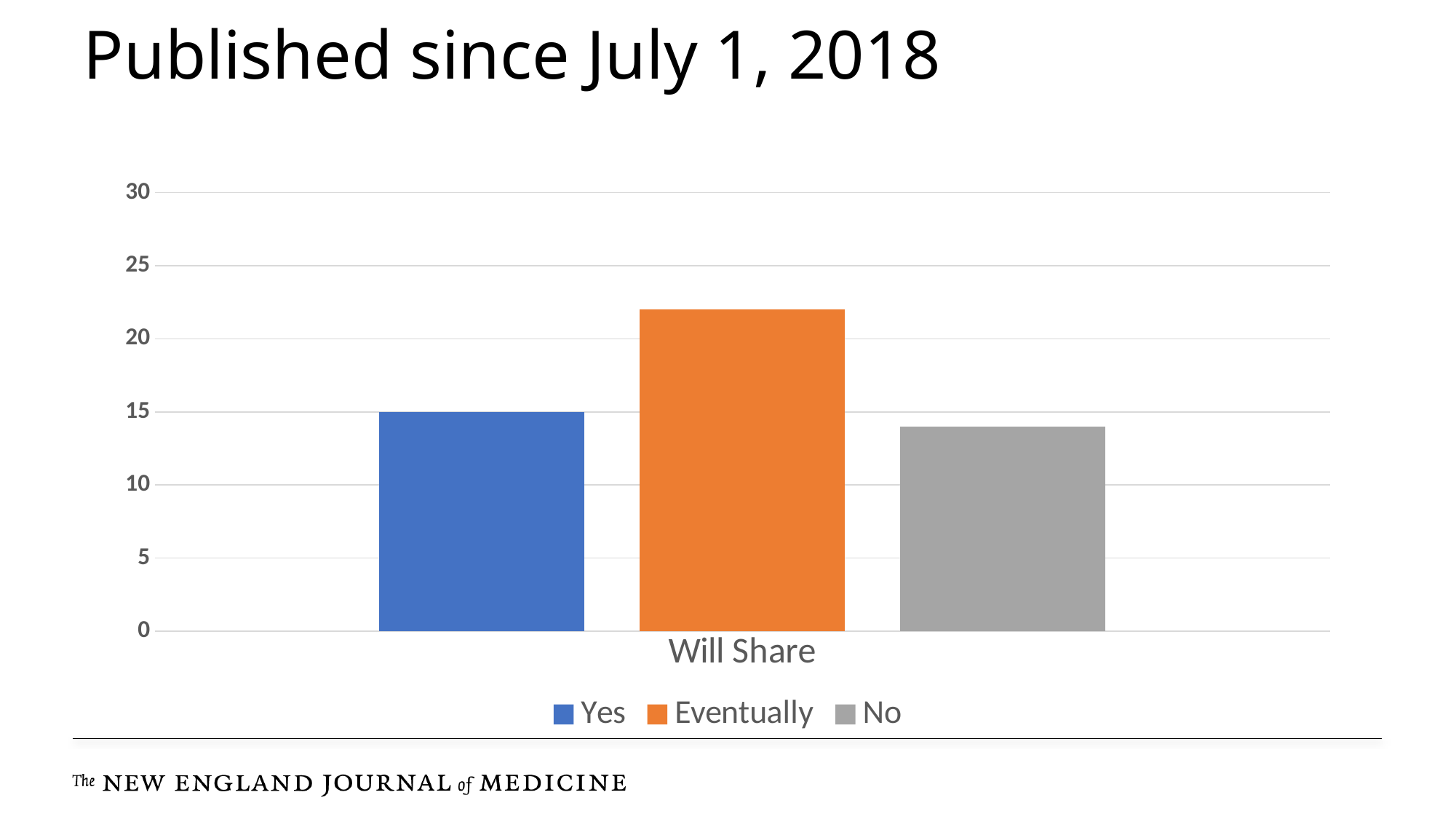
How many series does the legend list? 3 Which is larger, the Yes bar or the Eventually bar? Eventually Is the value for Eventually greater or less than 20? greater What kind of chart is shown on the slide? bar chart What is the value of the Yes bar for Will Share? 15 Is the value for Eventually greater or less than 25? less What colour is the Eventually bar? orange How many categories are shown on the x axis? 1 What is the title of the slide? Published since July 1, 2018 Is the value for No greater or less than 15? less Which series has the lowest bar? No Which series has the highest bar? Eventually